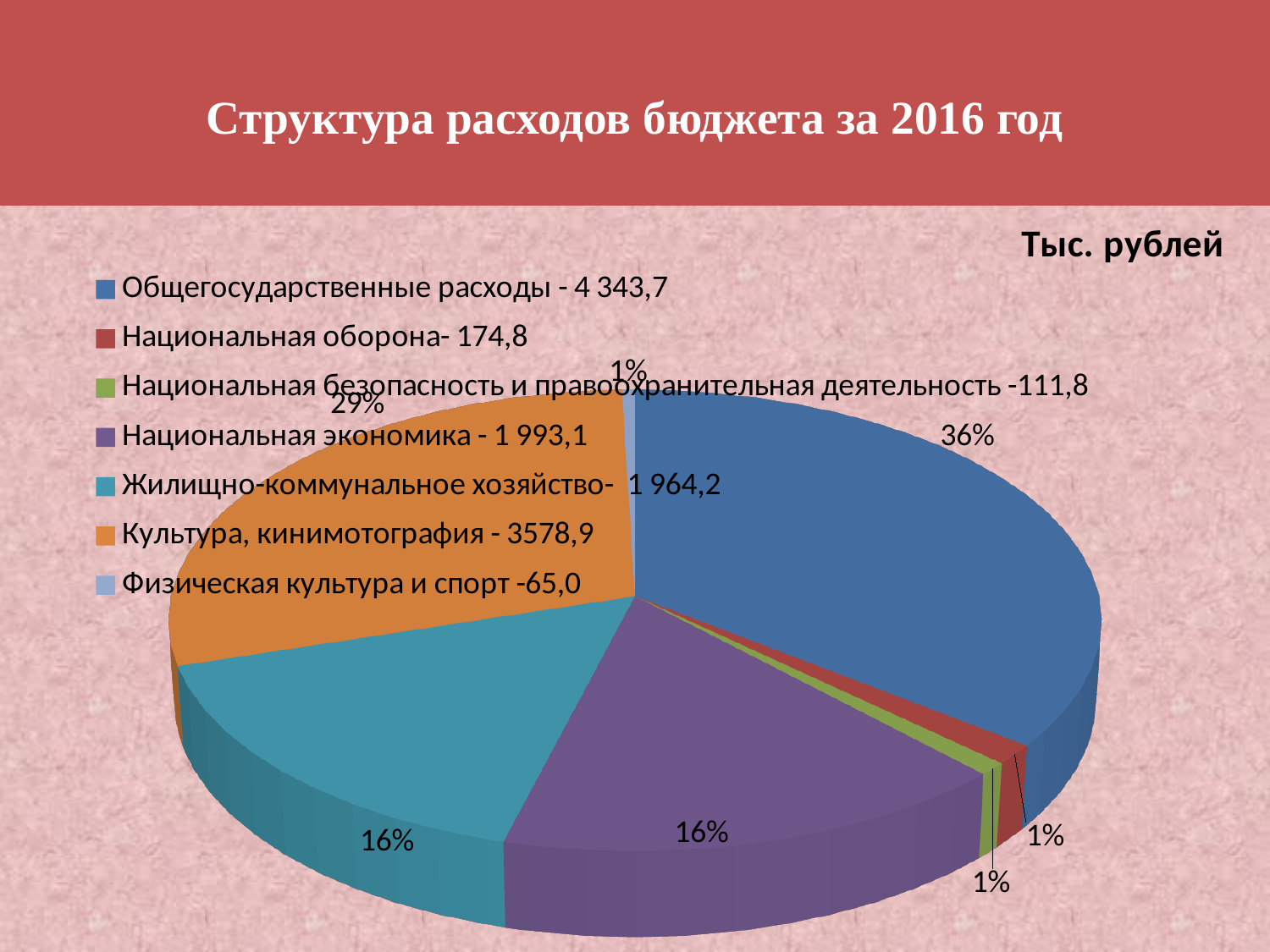
What share of the pie does Культура, кинимотография take? 29% What value does the legend give for Национальная оборона? 174,8 Which category has the largest share of the pie? Общегосударственные расходы Which is larger according to the legend: Национальная экономика or Жилищно-коммунальное хозяйство? Национальная экономика What share of the pie does Национальная экономика take? 16% How many categories does the legend of the pie chart list? 7 What share of the pie does Общегосударственные расходы take? 36% What kind of chart is shown on the slide? Pie chart What is the difference between the legend values for Общегосударственные расходы (4 343,7) and Культура, кинимотография (3578,9)? 764,8 According to the legend, which category has the smallest value? Физическая культура и спорт What value does the legend give for Жилищно-коммунальное хозяйство? 1 964,2 What is the title of the chart on the slide? Тыс. рублей